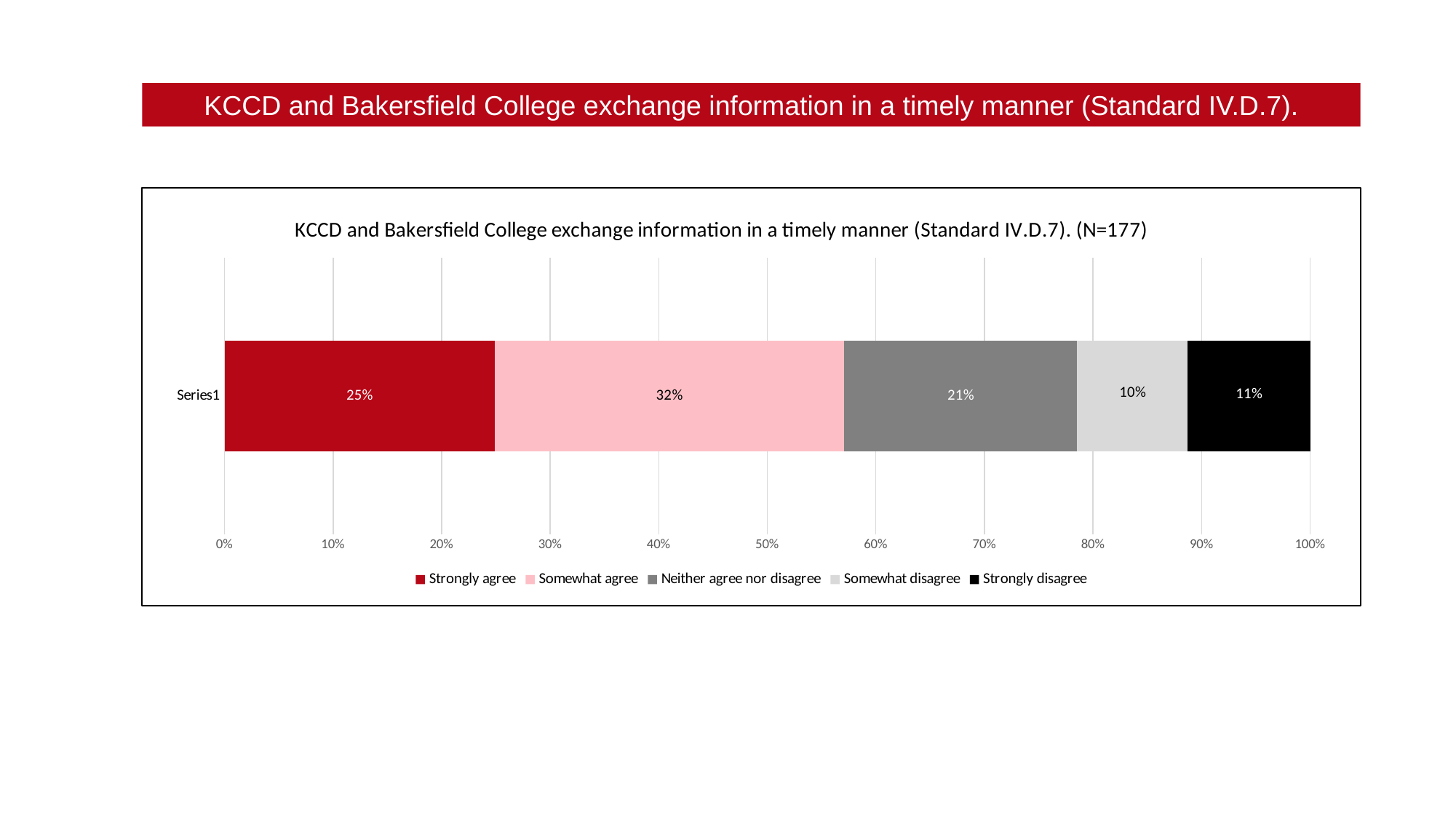
What is the difference between the Somewhat agree and Strongly agree percentages? 7% Which response option has the largest share? Somewhat agree What kind of chart is shown on the slide? Stacked bar chart What percentage of respondents selected Strongly agree? 25% What is the sample size (N) stated in the chart title? 177 What percentage of respondents selected Somewhat disagree? 10% What percentage of respondents selected Strongly disagree? 11% What percentage of respondents selected Neither agree nor disagree? 21% Which response option has the smallest share? Somewhat disagree What percentage of respondents selected Somewhat agree? 32% Which is larger, the share for Strongly agree or the share for Neither agree nor disagree? Strongly agree How many series does the legend list? 5